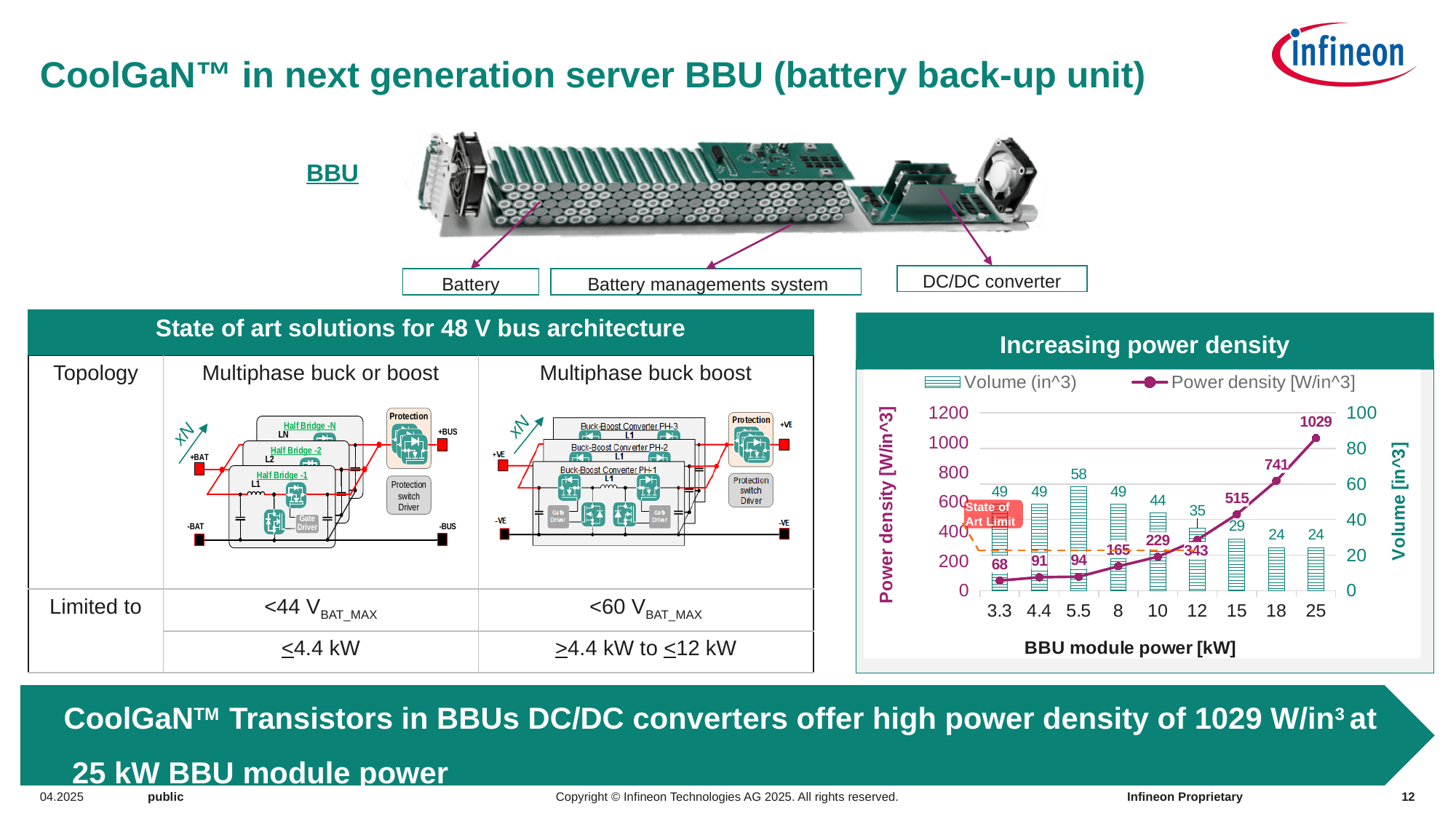
In the 'Increasing power density' chart, what is the difference in power density between 25 kW and 18 kW? 288 In the 'Increasing power density' chart, which has the larger volume: 10 kW or 15 kW? 10 kW In the 'Increasing power density' chart, how does the power density change as BBU module power increases from 3.3 kW to 25 kW? It rises In the 'Increasing power density' chart, what is the power density at 12 kW BBU module power? 343 In the 'Increasing power density' chart, how many series does the legend list? 2 In the 'Increasing power density' chart, at which BBU module power is the volume highest? 5.5 In the 'Increasing power density' chart, what is the volume (in^3) at 5.5 kW BBU module power? 58 In the 'Increasing power density' chart, how many BBU module power categories are shown on the x axis? 9 In the 'Increasing power density' chart, what is the difference in volume between 3.3 kW and 25 kW? 25 In the 'Increasing power density' chart, what is the label of the left vertical axis? Power density [W/in^3] In the 'Increasing power density' chart, what is the power density at 25 kW BBU module power? 1029 In the 'Increasing power density' chart, at which BBU module power is the power density lowest? 3.3